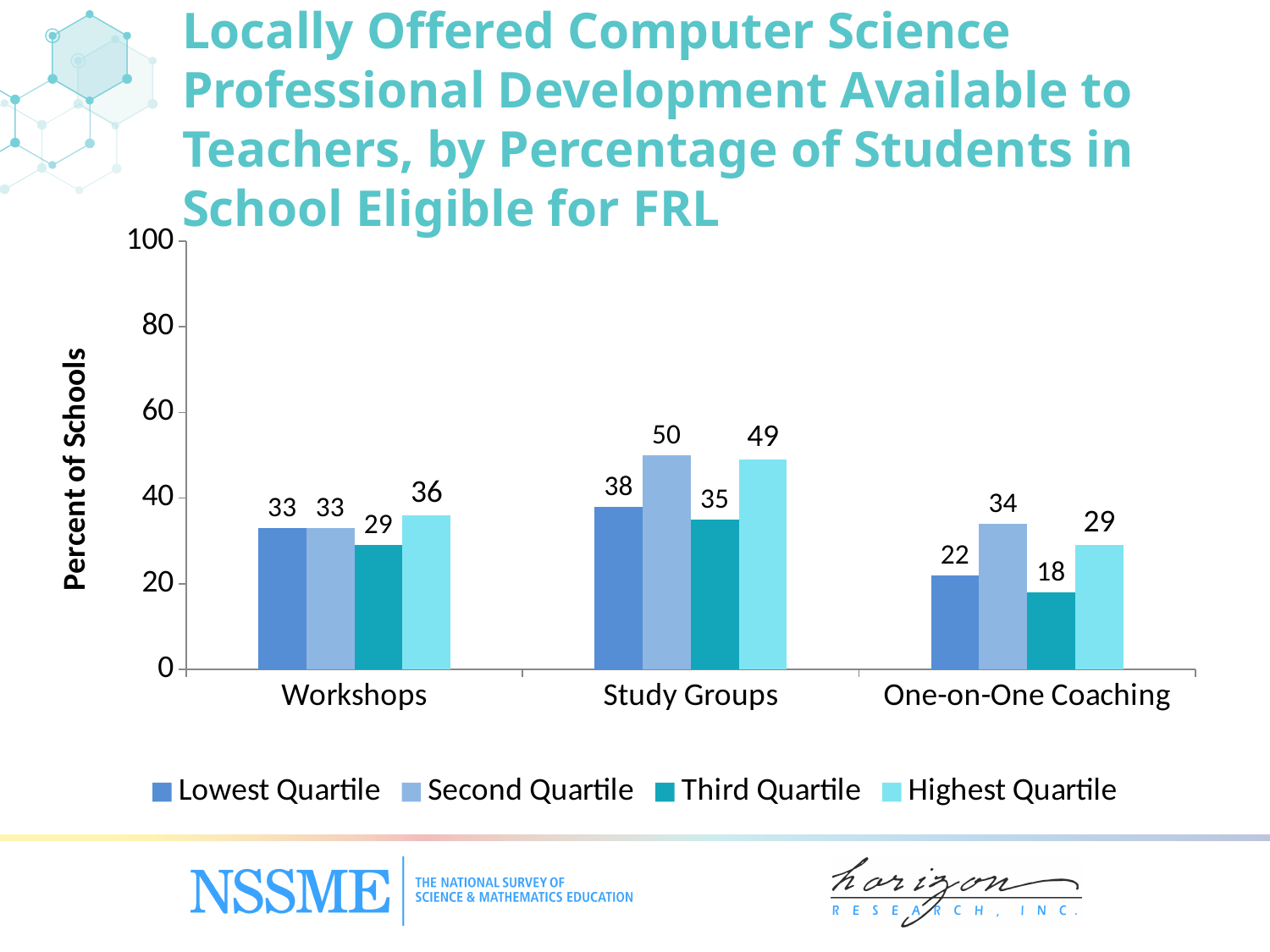
What is the value for Highest Quartile in the Workshops category? 36 Which category has the highest value for the Lowest Quartile series? Study Groups What is the label of the y axis? Percent of Schools How many categories are shown on the x axis? 3 What is the value for Third Quartile in the One-on-One Coaching category? 18 Is the value for Second Quartile in Study Groups greater or less than 40? greater What is the difference between the Second Quartile and Third Quartile values in the Study Groups category? 15 What is the value for Second Quartile in the Study Groups category? 50 What kind of chart is shown on the slide? bar chart Which is larger in the One-on-One Coaching category: the Second Quartile value or the Highest Quartile value? Second Quartile How many series does the legend list? 4 Which category has the lowest value for the Highest Quartile series? One-on-One Coaching